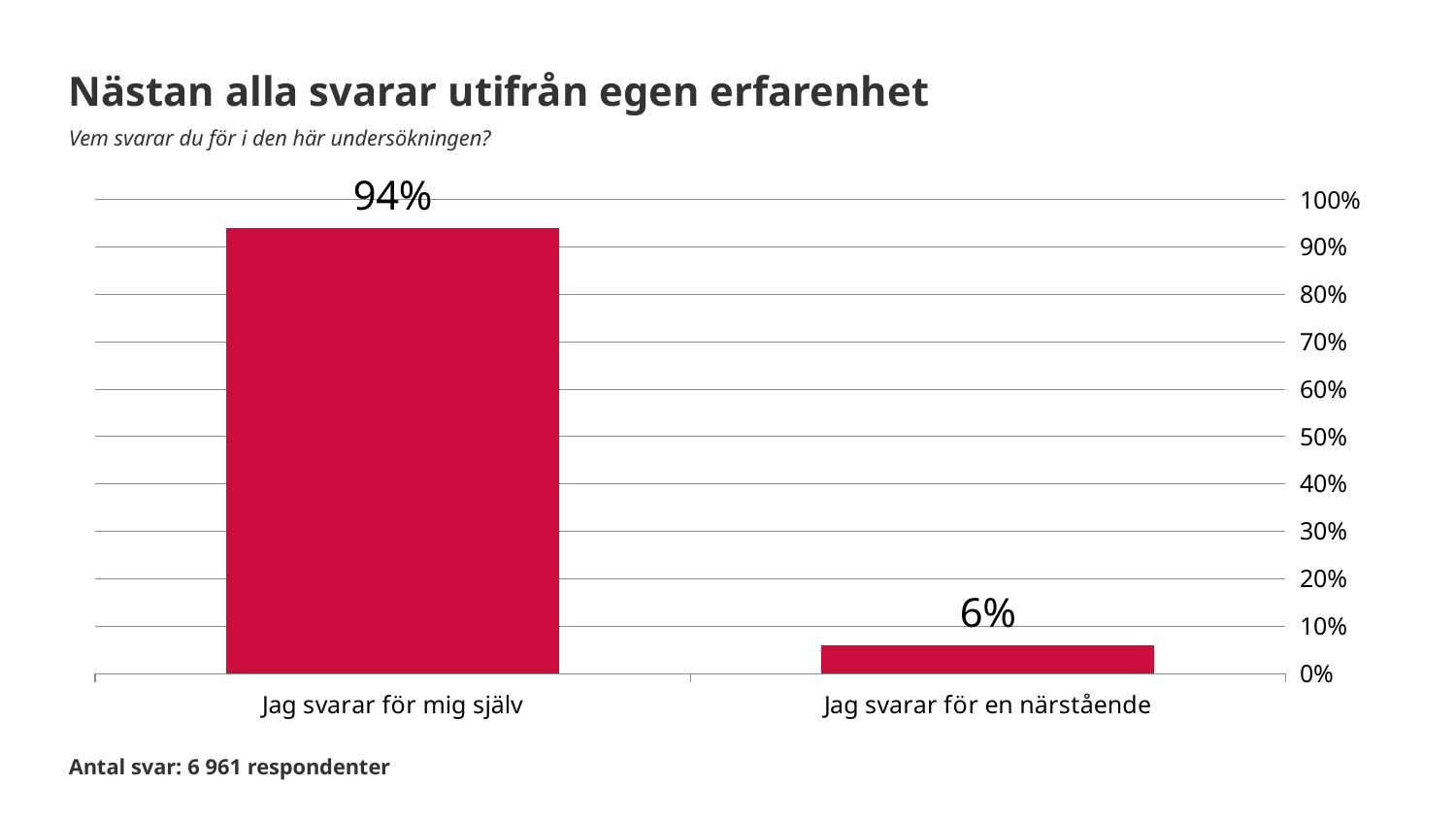
What is the value for "Jag svarar för en närstående"? 6% Is the value for "Jag svarar för mig själv" greater or less than 90%? greater How many respondents answered, according to the note below the chart? 6 961 What is the title of the slide? Nästan alla svarar utifrån egen erfarenhet What is the value for "Jag svarar för mig själv"? 94% How many categories are shown on the x axis? 2 Is the value for "Jag svarar för en närstående" greater or less than 10%? less Which category has the highest value? Jag svarar för mig själv Which is larger: the value for "Jag svarar för mig själv" or for "Jag svarar för en närstående"? Jag svarar för mig själv What is the difference between the values for "Jag svarar för mig själv" and "Jag svarar för en närstående"? 88% What kind of chart is shown on the slide? bar chart Which category has the lowest value? Jag svarar för en närstående